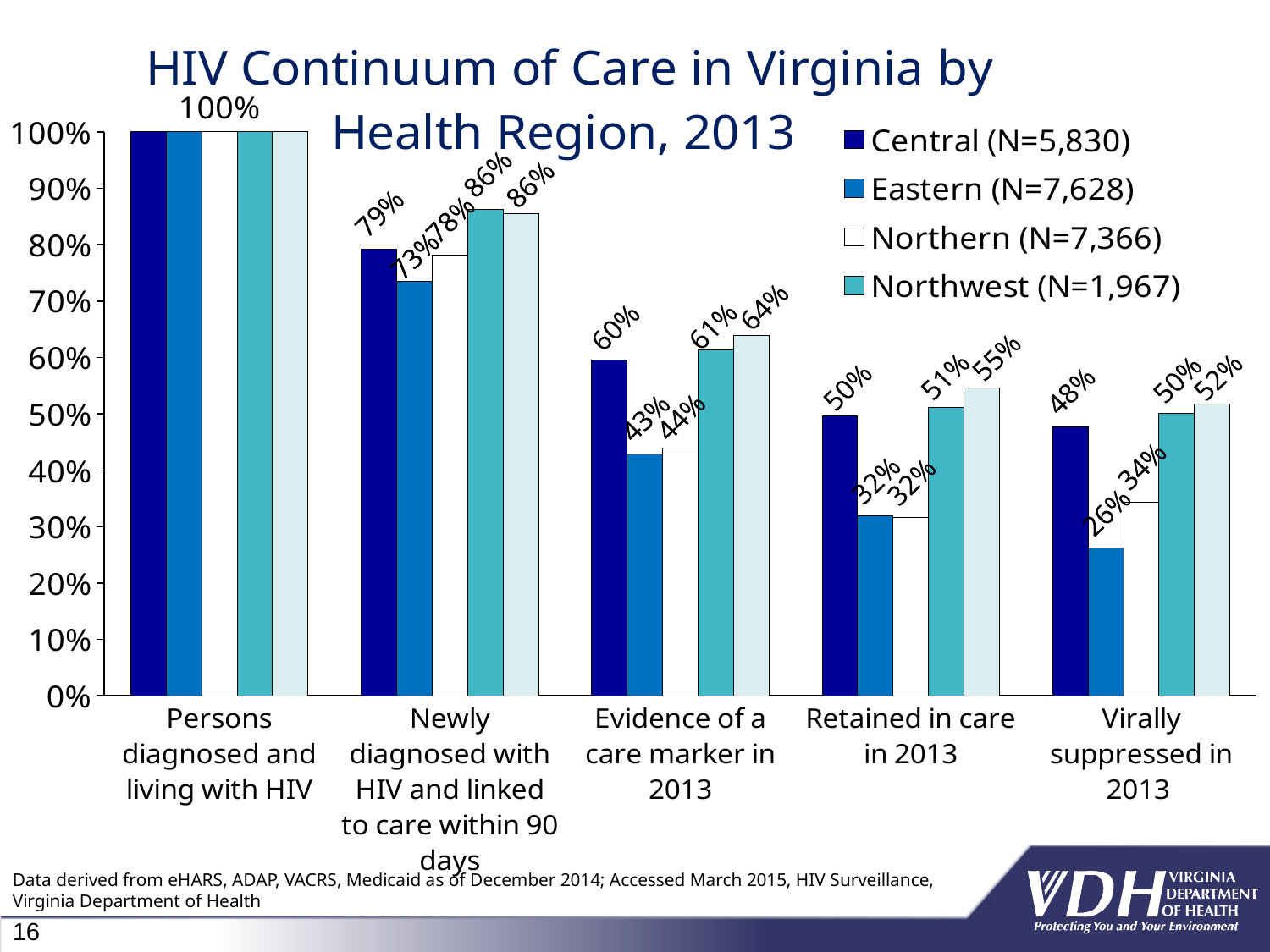
How many series does the legend list? 4 In the 'Retained in care in 2013' category, which is larger: the Central value or the Northern value? Central What is the value for Northwest in the 'Newly diagnosed with HIV and linked to care within 90 days' category? 86% What is the value for Northern in the 'Retained in care in 2013' category? 32% Do the Central values rise or fall moving from left to right across the categories? Fall What is the difference between the Central and Eastern values in the 'Evidence of a care marker in 2013' category? 17 percentage points How many categories are shown along the x axis? 5 What type of chart is shown on the slide? Bar chart What is the title of the chart? HIV Continuum of Care in Virginia by Health Region, 2013 What is the value for Central in the 'Evidence of a care marker in 2013' category? 60% Which region has the lowest value in the 'Virally suppressed in 2013' category? Eastern What is the value for Eastern in the 'Virally suppressed in 2013' category? 26%